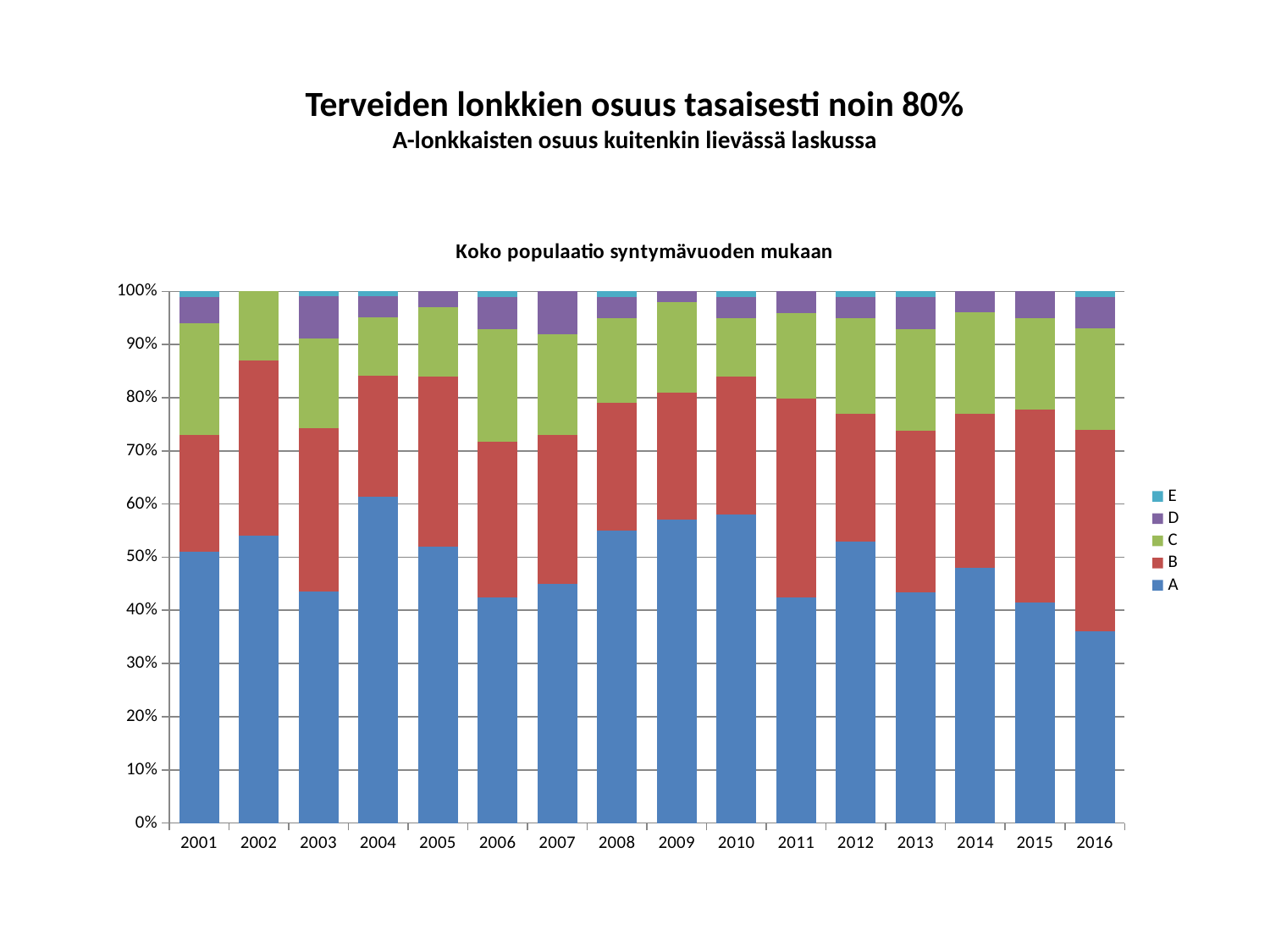
Is the share of series A in 2004 greater or less than 50%? greater How many years are shown on the x axis? 16 Is the share of series A in 2016 greater or less than 40%? less Is the share of series A in 2006 greater or less than 50%? less What is the title of the chart? Koko populaatio syntymävuoden mukaan Which colour represents series A in the chart? Blue How many series does the legend list? 5 What does each stacked bar total? 100% What kind of chart is shown on the slide? Stacked bar chart Which year has a larger share of series A, 2010 or 2011? 2010 In which year is the share of series A the highest? 2004 In which year is the share of series A the lowest? 2016